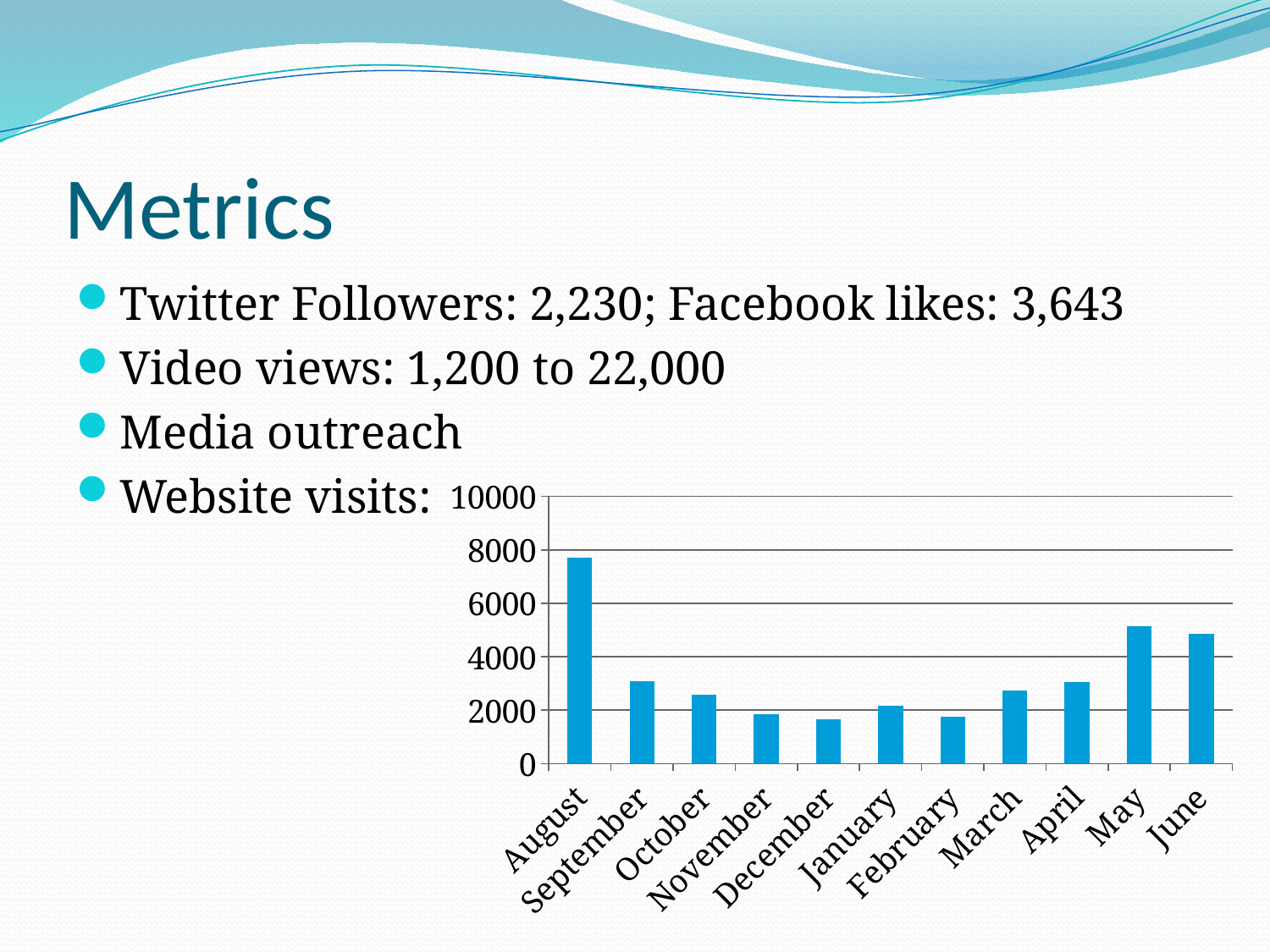
Do the values rise or fall from August to December? fall Is the value for September greater or less than 2000? greater How many months are shown on the x axis of the chart? 11 According to the slide text, what does the chart show? Website visits Is the value for November greater or less than 2000? less Which is larger, the value for March or the value for November? March Is the value for December greater or less than 2000? less Which month has the highest bar in the chart? August Which is larger, the value for August or the value for May? August What kind of chart is shown on the slide? bar chart